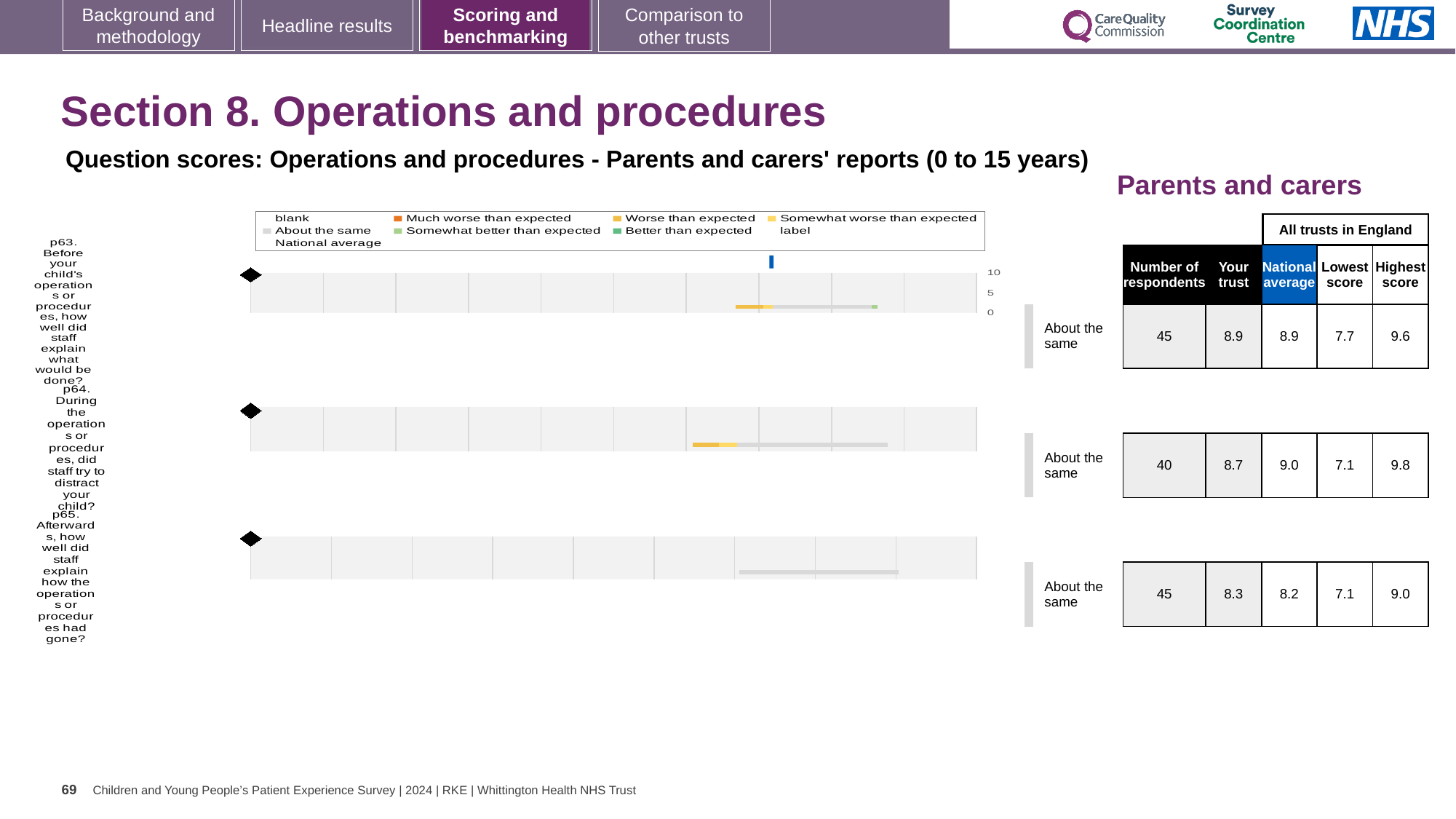
Which question has the lowest 'Your trust' score? p65 What is the national average score for p64 (did staff try to distract your child during the operation)? 9.0 What is the 'Your trust' score for p63 (how well staff explained what would be done before the operation)? 8.9 According to the legend, what does the blue marker represent? National average How many questions (p63, p64, p65) are plotted on the slide? 3 What is the lowest score across all trusts in England for p63? 7.7 What kind of chart is used to show the question scores for p63, p64 and p65? bar chart Which question has the highest 'Your trust' score? p63 Which has the larger 'Your trust' score, p63 or p65? p63 How many respondents answered p65 (how well staff explained how the operation had gone)? 45 What benchmark category is shown for p64? About the same What is the difference between the highest score and the lowest score for p64? 2.7